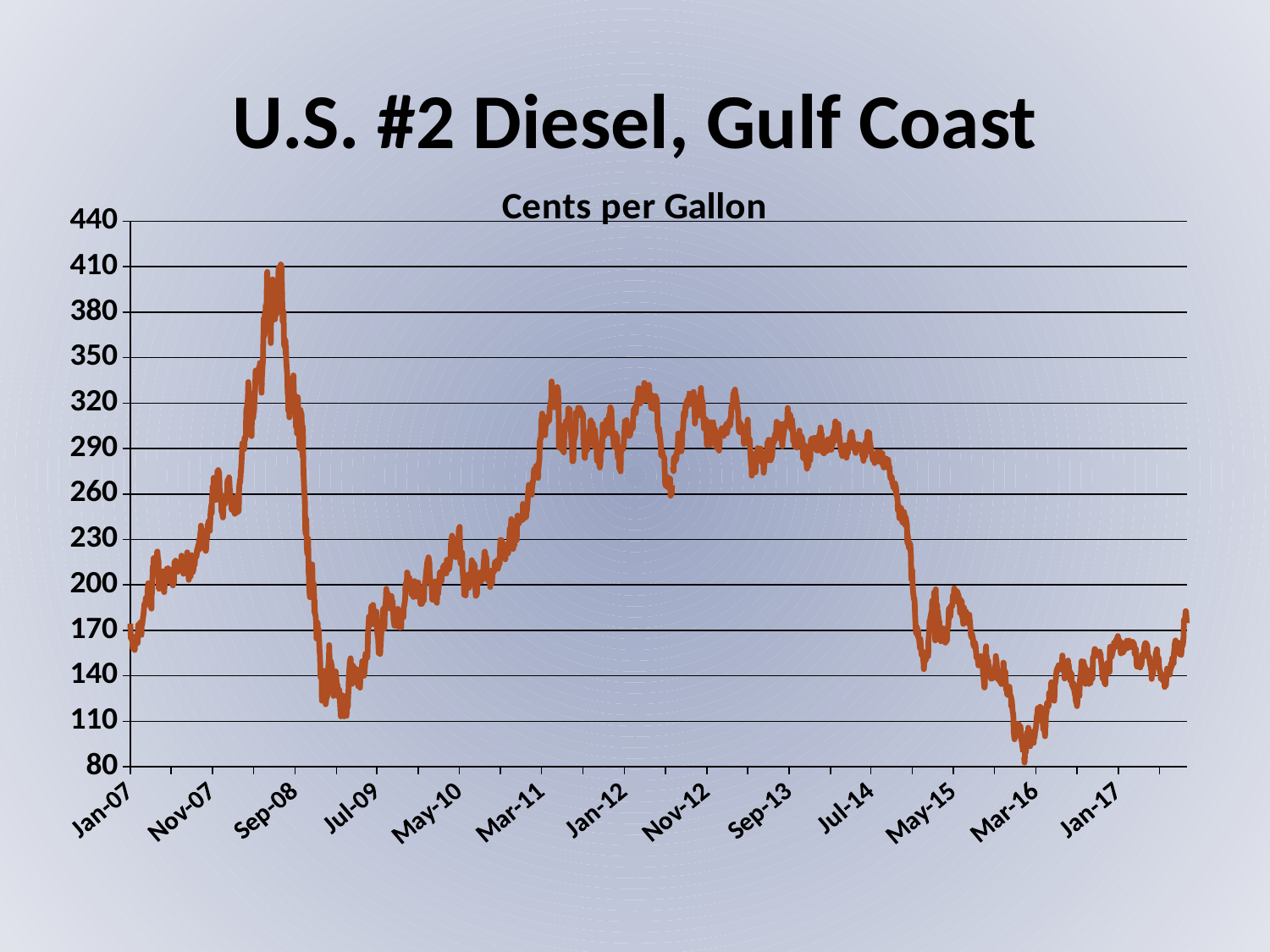
What kind of chart is shown on the slide? line chart Do the values rise or fall between Jul-14 and Mar-16? fall Is the value at Jul-09 greater or less than 200? less Around which x-axis label does the diesel price reach its lowest point? Mar-16 Is the value at Mar-16 greater or less than 140? less What is the title of the chart? U.S. #2 Diesel, Gulf Coast Is the value at Jul-14 greater or less than 200? greater What unit is the diesel price plotted in, according to the chart subtitle? Cents per Gallon Which is larger, the value at Jan-12 or the value at Mar-16? Jan-12 How many labels are shown on the x axis? 13 Around which x-axis label does the diesel price reach its highest point? Sep-08